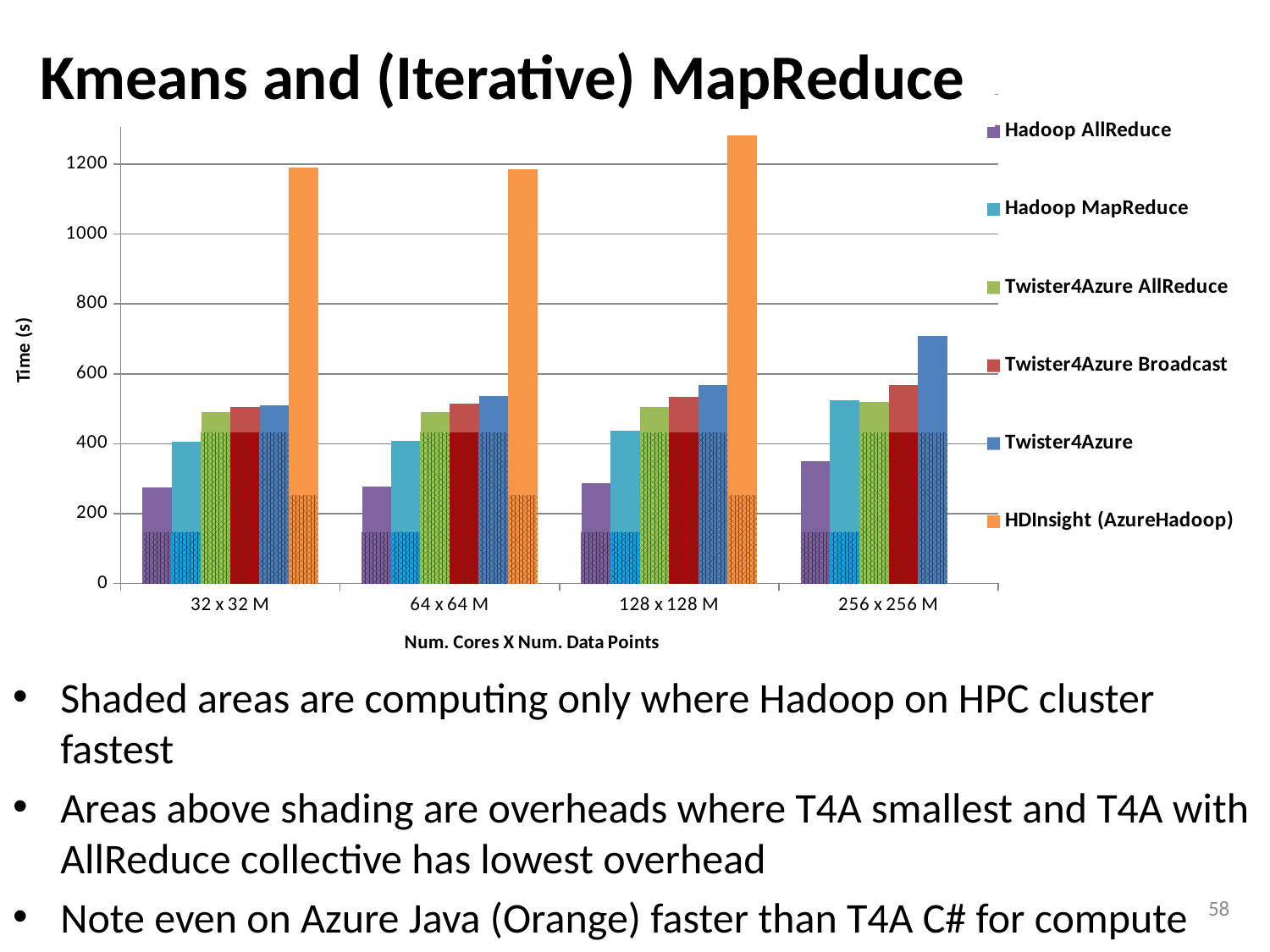
At 256 x 256 M, which is larger: Twister4Azure or Hadoop MapReduce? Twister4Azure Is the value for Hadoop AllReduce at 32 x 32 M greater or less than 400? less Which series has the lowest value for 128 x 128 M? Hadoop AllReduce Do the values for Twister4Azure rise or fall from 32 x 32 M to 256 x 256 M? rise For HDInsight (AzureHadoop), which is larger: the value at 64 x 64 M or at 128 x 128 M? 128 x 128 M What is the title of the y axis? Time (s) How many categories are shown on the x axis? 4 What kind of chart is shown on the slide? bar chart Is the value for Twister4Azure at 256 x 256 M greater or less than 600? greater How many series does the legend list? 6 Is the value for HDInsight (AzureHadoop) at 128 x 128 M greater or less than 1200? greater Which series has the highest value for 32 x 32 M? HDInsight (AzureHadoop)